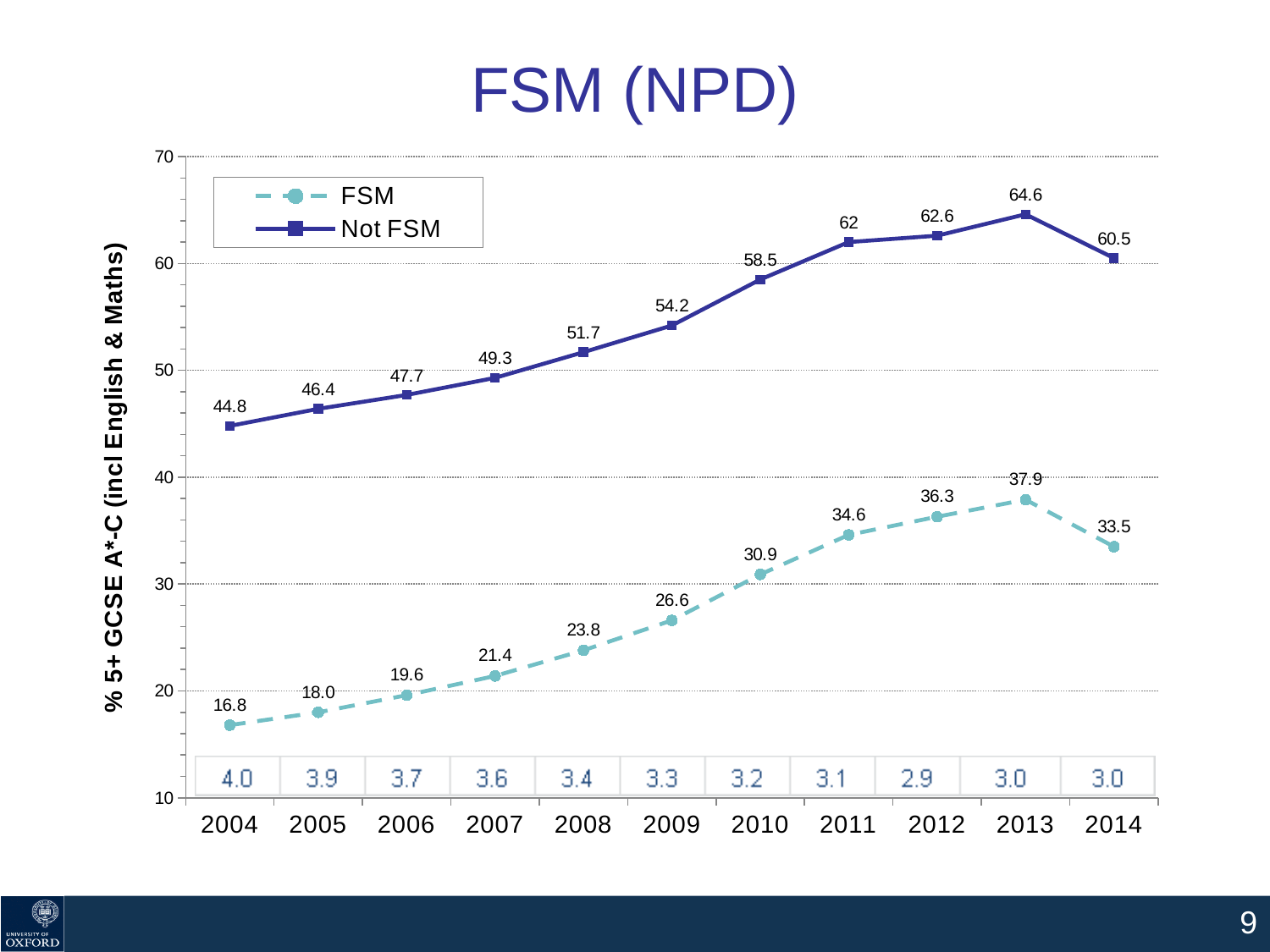
How many years are shown on the x axis? 11 What is the difference between Not FSM and FSM in 2013? 26.7 What is the value for FSM in 2014? 33.5 How many series does the legend list? 2 Which is larger, the FSM value in 2011 or the FSM value in 2012? 2012 What kind of chart is shown? line chart What is the title of the chart? FSM (NPD) In which year is the Not FSM series highest? 2013 What is the value for Not FSM in 2010? 58.5 What is the value for FSM in 2007? 21.4 In which year is the FSM series lowest? 2004 Is the value for Not FSM in 2009 greater or less than 50? greater